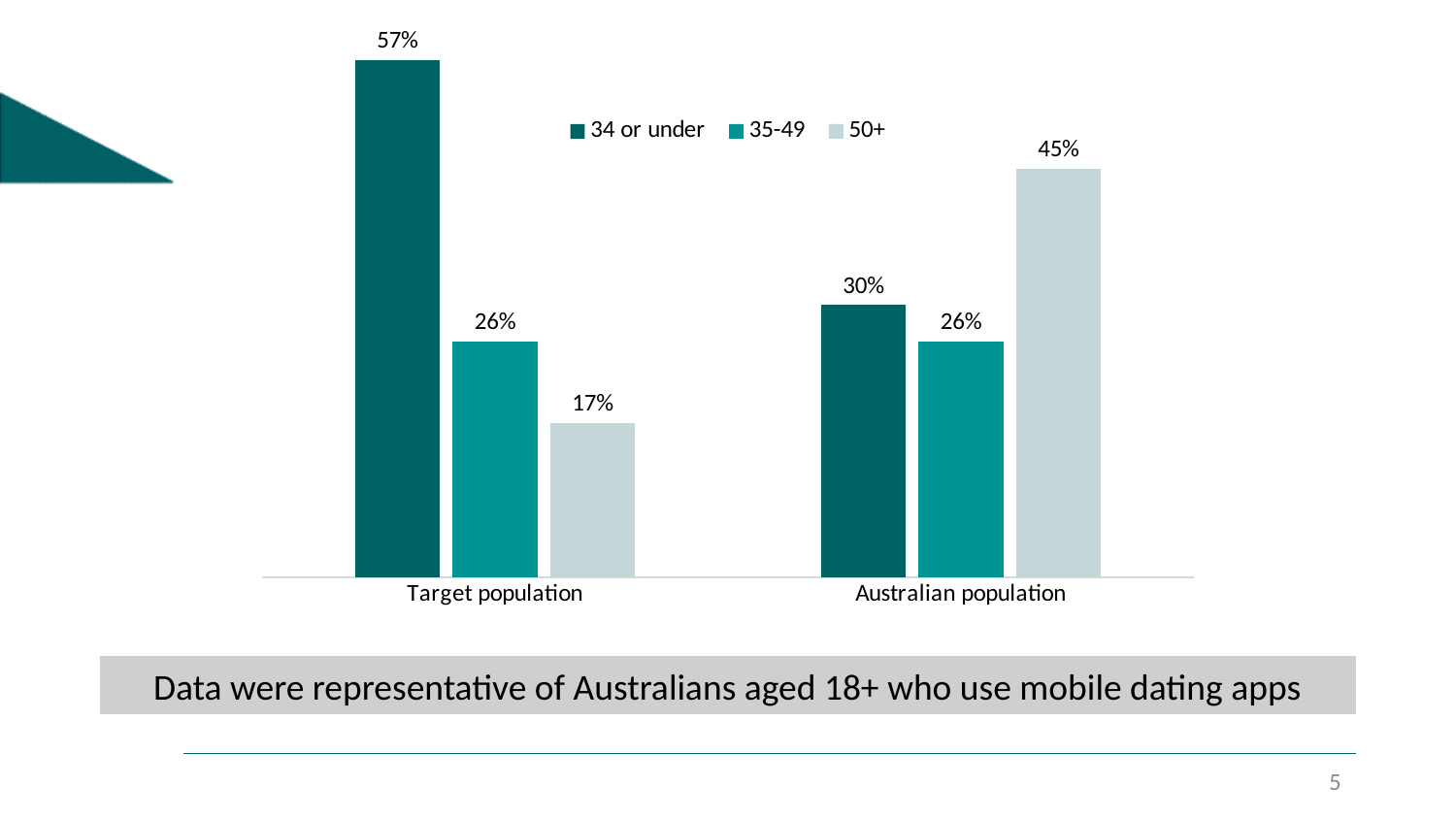
What is the value for '50+' in the Australian population? 45% How many series does the legend list? 3 Which age group has the highest value in the Australian population? 50+ What is the difference between the '34 or under' values for the Target population and the Australian population? 27% Which age group has the lowest value in the Target population? 50+ Which age group has the highest value in the Target population? 34 or under How many categories are shown on the x axis? 2 What is the value for '34 or under' in the Target population? 57% Which is larger: the '50+' value for the Target population or for the Australian population? Australian population What is the value for '35-49' in the Target population? 26% What kind of chart is shown on the slide? Bar chart What is the value for '34 or under' in the Australian population? 30%